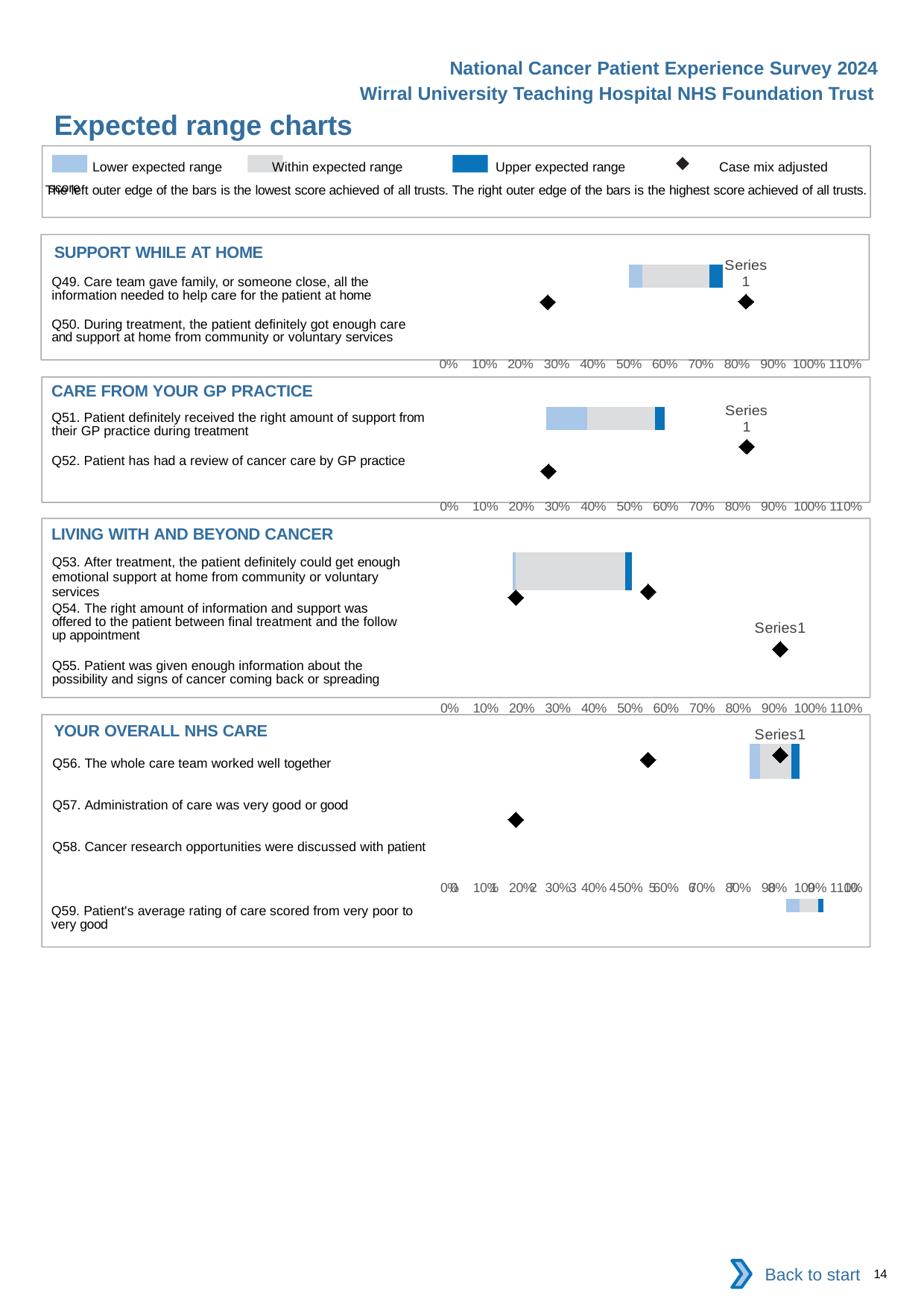
According to the legend at the top of the slide, what does the diamond marker represent? Case mix adjusted score How many survey questions are listed in the YOUR OVERALL NHS CARE section? 4 How many survey questions are listed in the CARE FROM YOUR GP PRACTICE section? 2 In the LIVING WITH AND BEYOND CANCER chart, is the value for the leftmost diamond greater or less than 40%? less What is the highest percentage tick shown on the x axis of the SUPPORT WHILE AT HOME chart? 110% In the SUPPORT WHILE AT HOME chart, is the value for the rightmost diamond greater or less than 70%? greater In the CARE FROM YOUR GP PRACTICE chart, is the value for the upper diamond greater or less than 70%? greater How many survey questions are listed in the LIVING WITH AND BEYOND CANCER section? 3 What kind of chart is used in the SUPPORT WHILE AT HOME section? bar chart